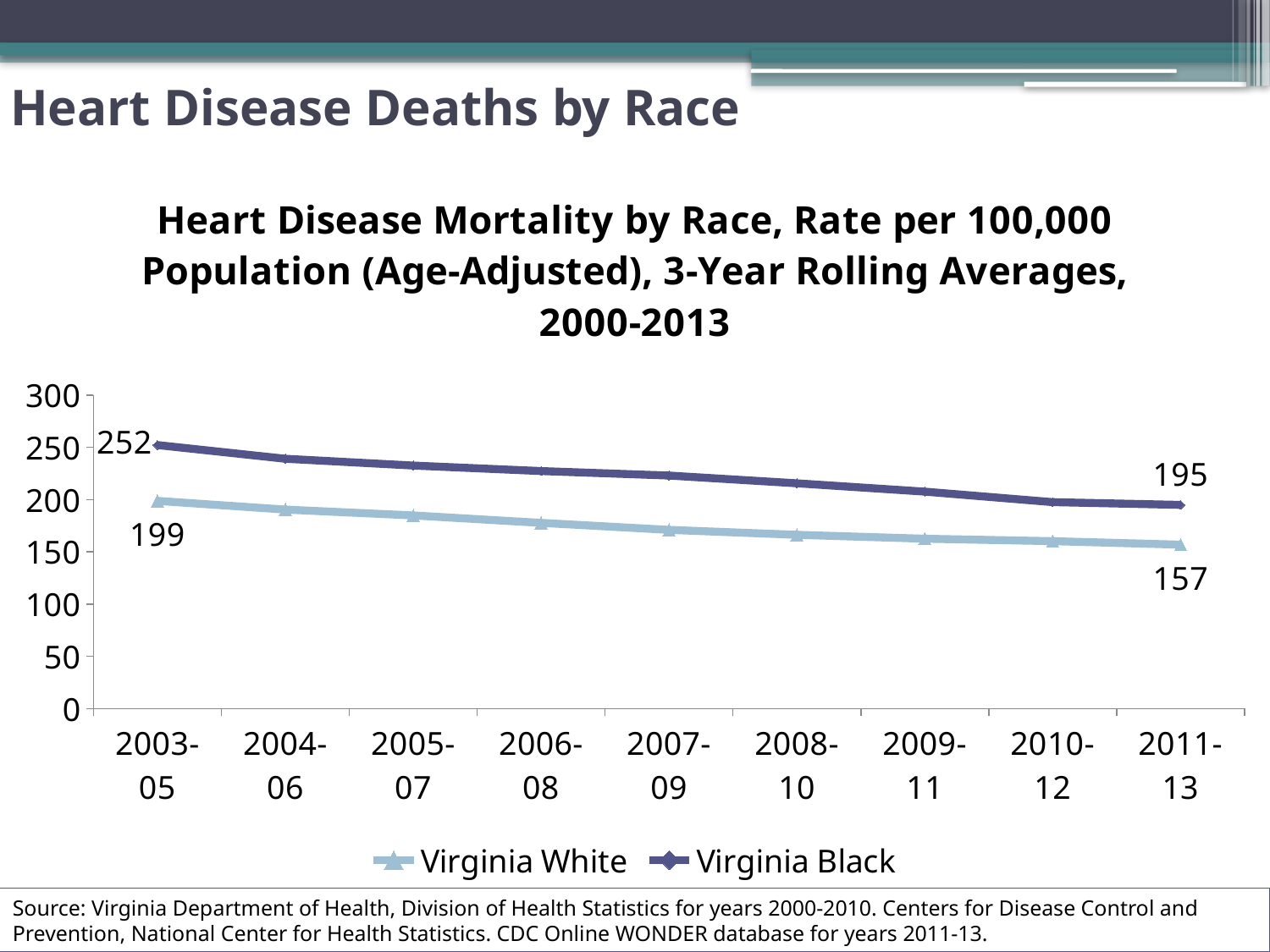
How many series does the legend list? 2 What is the Virginia White heart disease mortality rate for 2011-13? 157 By how much did the Virginia Black rate fall from 2003-05 to 2011-13? 57 What is the difference between the Virginia Black and Virginia White rates in 2003-05? 53 What is the Virginia White heart disease mortality rate for 2003-05? 199 Is the Virginia White value for 2007-09 greater or less than 200? less What is the Virginia Black heart disease mortality rate for 2011-13? 195 Which series has the higher rate in 2011-13, Virginia White or Virginia Black? Virginia Black How many time periods are shown on the x axis? 9 What is the Virginia Black heart disease mortality rate for 2003-05? 252 What kind of chart is shown on the slide? line chart Do the Virginia Black rates rise or fall from 2003-05 to 2011-13? fall